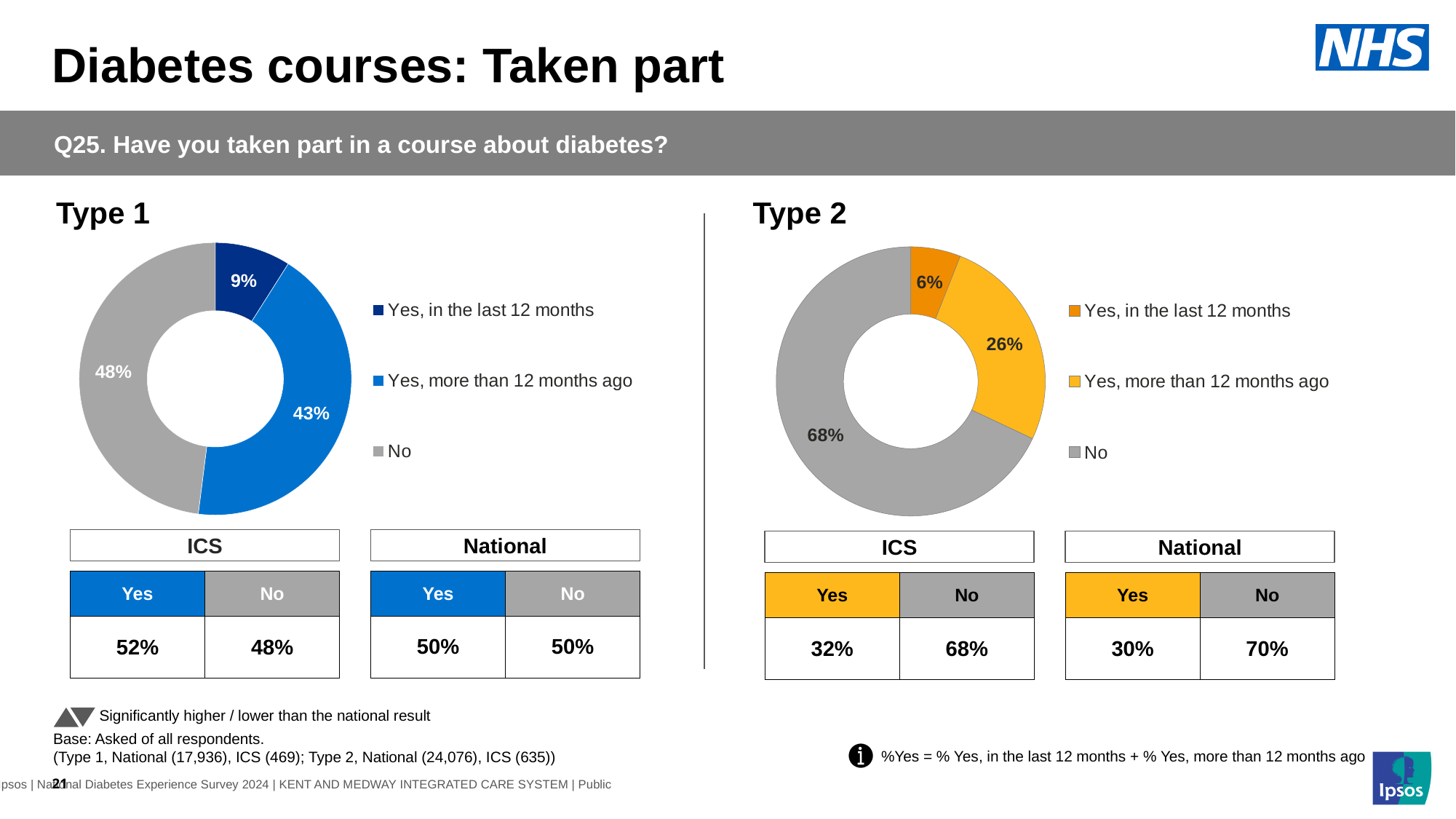
In the Type 2 chart, what percentage answered 'No'? 68% In the Type 2 chart, which category has the smallest share? Yes, in the last 12 months How many categories does the Type 2 chart show? 3 In the Type 2 chart, what is the difference between the 'No' share and the 'Yes, more than 12 months ago' share? 42% In the Type 1 chart, which category has the largest share? No In the Type 1 chart, what percentage answered 'Yes, more than 12 months ago'? 43% In the Type 2 chart, what is the combined share of the two 'Yes' categories? 32% In the Type 1 chart, which is larger: 'Yes, more than 12 months ago' or 'Yes, in the last 12 months'? Yes, more than 12 months ago In the Type 2 chart, what percentage answered 'Yes, more than 12 months ago'? 26% In the Type 1 chart, what colour is the 'No' segment? Grey What kind of chart is the Type 1 chart? Doughnut chart In the Type 1 chart, what percentage answered 'Yes, in the last 12 months'? 9%